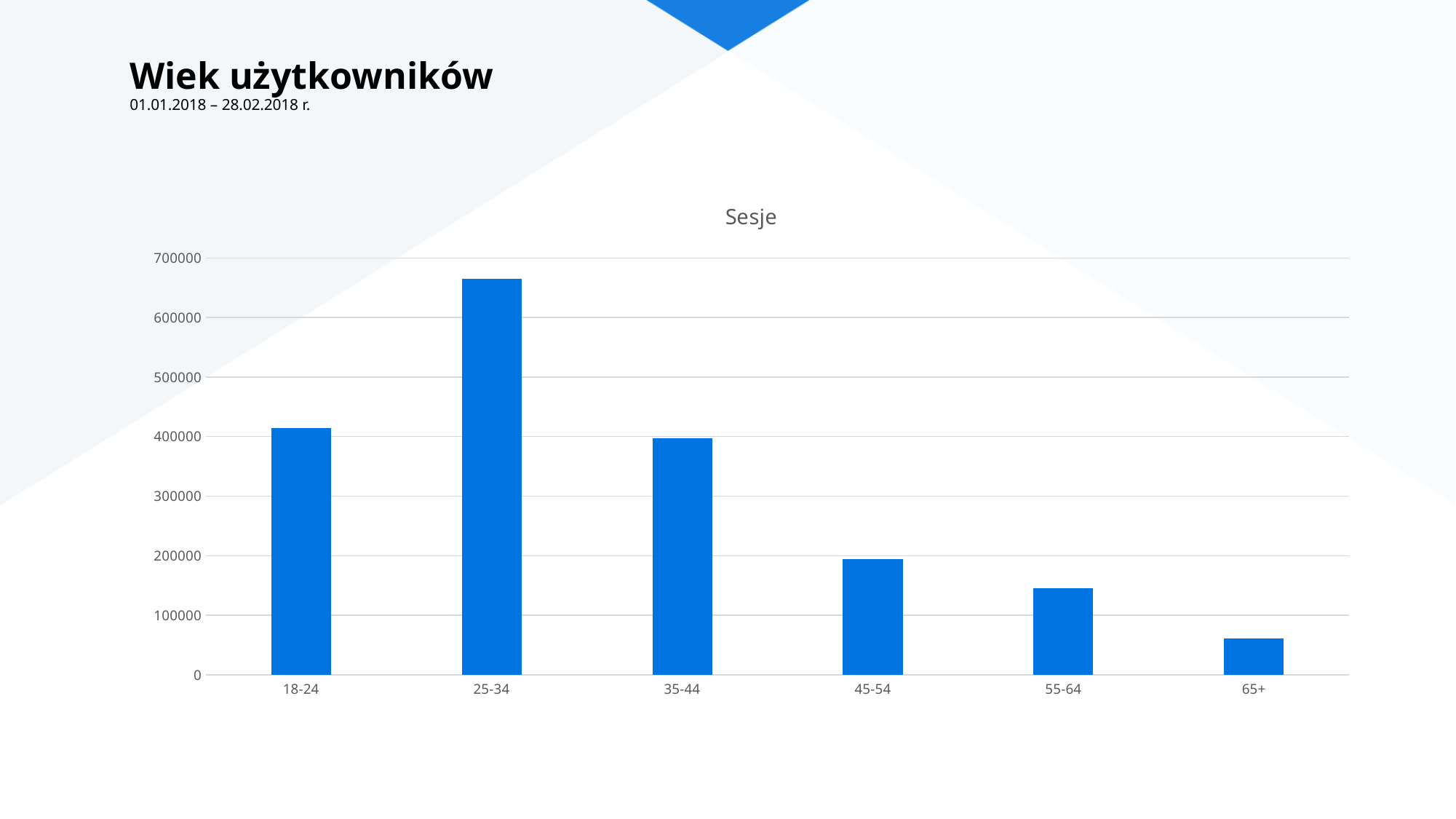
Which has more sessions, 25-34 or 18-24? 25-34 How many age groups are shown on the x axis? 6 Is the value for 25-34 greater or less than 600000? greater What is the title of the chart? Sesje Is the value for 55-64 greater or less than 100000? greater Is the value for 45-54 greater or less than 300000? less Which age group has the lowest number of sessions? 65+ What kind of chart is shown on the slide? bar chart Which has more sessions, 45-54 or 55-64? 45-54 Which age group has the highest number of sessions? 25-34